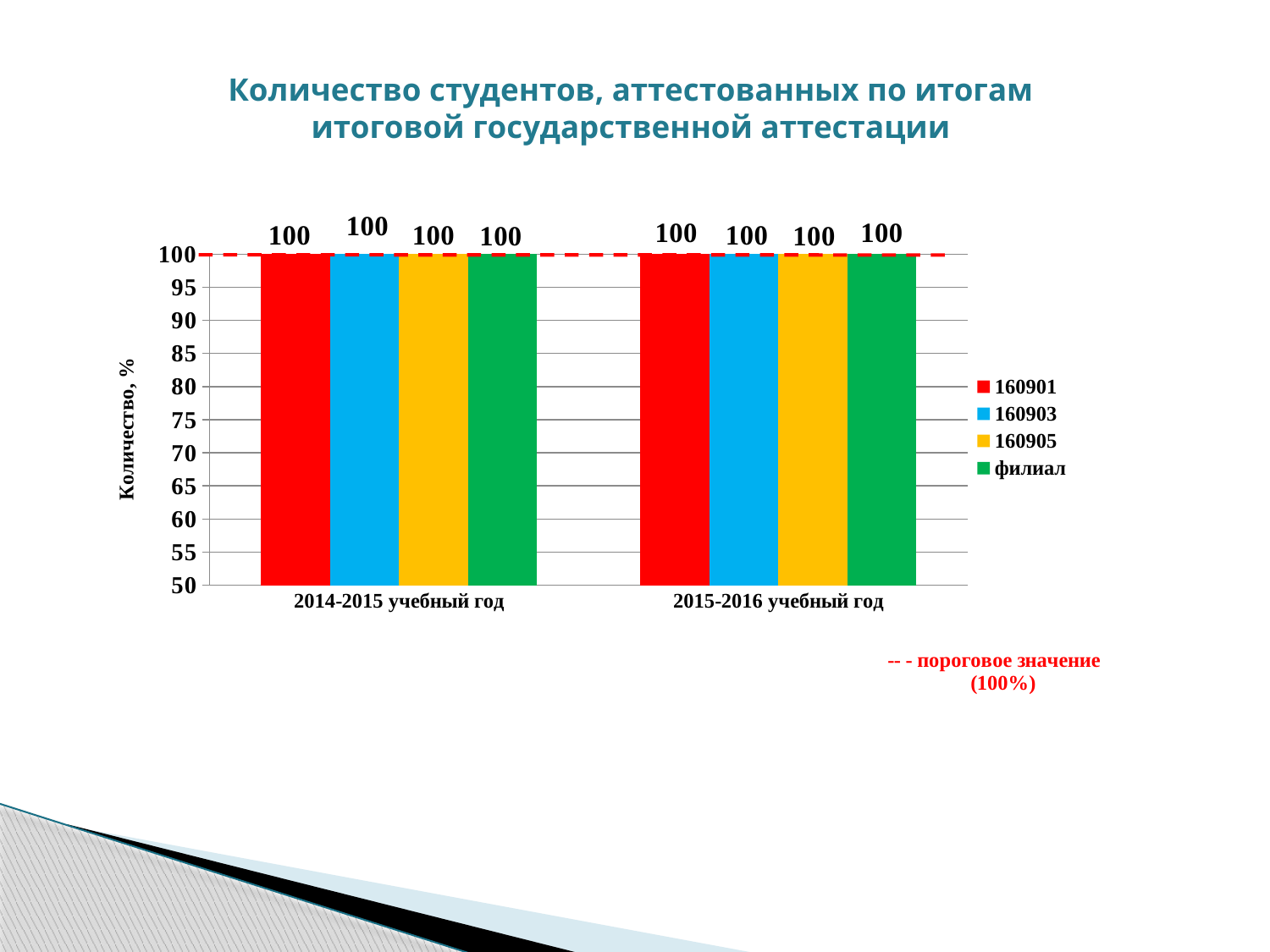
What is the value for 160905 in 2014-2015 учебный год? 100 What does the red dashed line on the chart represent? пороговое значение (100%) What is the difference between the value for 160901 in 2014-2015 учебный год and in 2015-2016 учебный год? 0 How many series does the legend list? 4 What is the value for 160901 in 2014-2015 учебный год? 100 What is the value for 160903 in 2015-2016 учебный год? 100 What is the value for филиал in 2015-2016 учебный год? 100 How many categories are shown on the x axis? 2 What kind of chart is shown on the slide? bar chart Is the value for филиал in 2014-2015 учебный год greater or less than 90? greater Do the values for 160905 rise, fall or stay the same from 2014-2015 учебный год to 2015-2016 учебный год? stay the same What is the label of the y axis? Количество, %